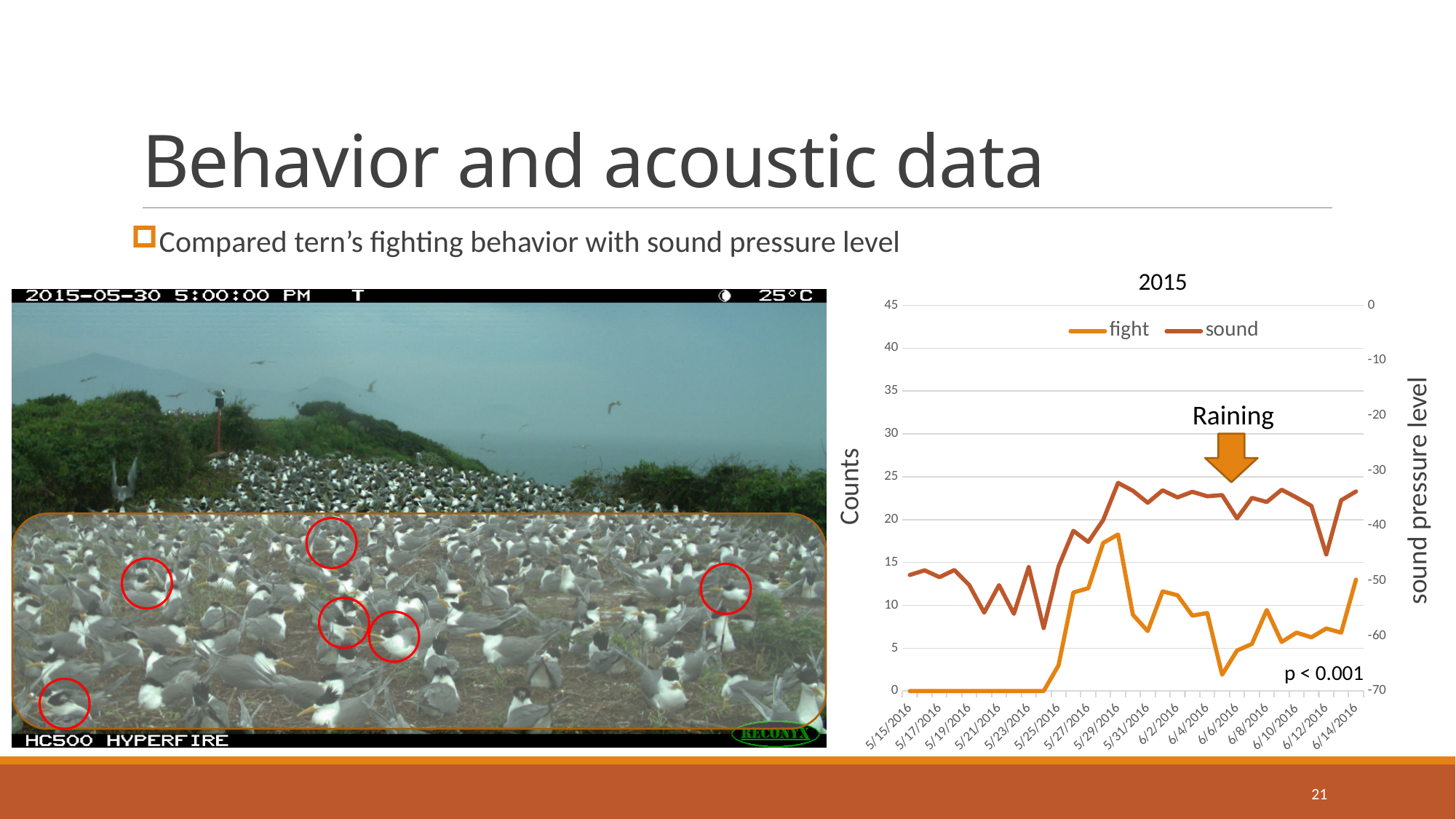
How many date labels are shown on the x axis? 16 Is the fight count on 6/14/2016 greater or less than 10? greater What is the fight count on 5/15/2016? 0 Does the fight count rise or fall between 5/25/2016 and 5/29/2016? rise What annotation is written above the arrow pointing at the chart? Raining What is the title of the chart? 2015 On which date does the fight series reach its highest value? 5/29/2016 Is the fight count on 5/29/2016 greater or less than 15? greater On which date does the sound series reach its lowest value? 5/24/2016 What kind of chart is shown on the slide? line chart How many series does the chart legend list? 2